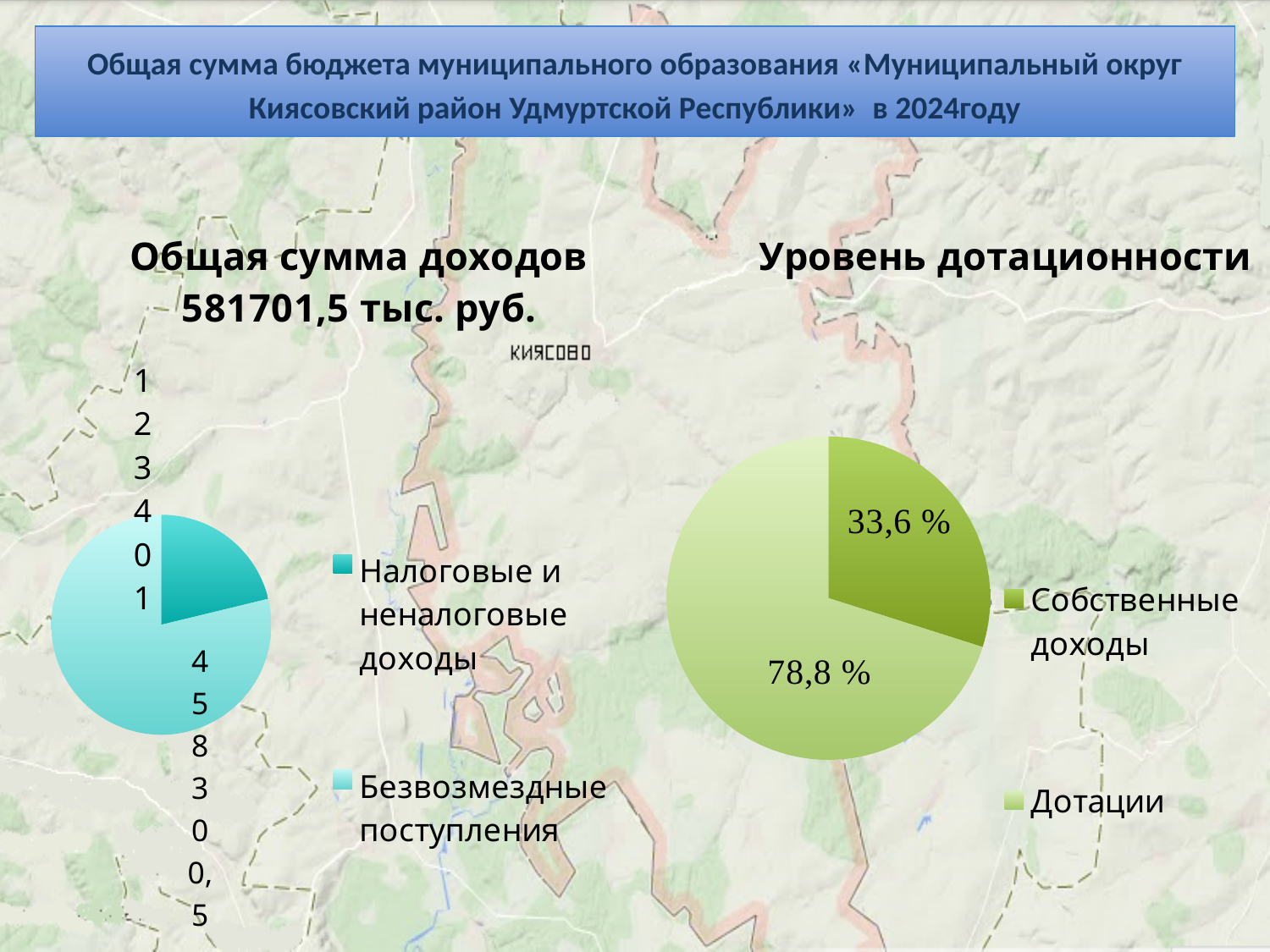
On the chart titled «Уровень дотационности», which category has the smaller slice? Собственные доходы On the chart titled «Уровень дотационности», what percentage is shown for «Дотации»? 78,8 % On the chart titled «Общая сумма доходов», what is the value for «Налоговые и неналоговые доходы»? 123401 On the chart titled «Общая сумма доходов», which category has the larger value? Безвозмездные поступления On the chart titled «Уровень дотационности», is the slice for «Дотации» larger or smaller than the slice for «Собственные доходы»? Larger On the chart titled «Общая сумма доходов», what is the value for «Безвозмездные поступления»? 458300,5 On the chart titled «Уровень дотационности», what percentage is shown for «Собственные доходы»? 33,6 % How many pie charts are shown on the slide? 2 What kind of chart is the one titled «Общая сумма доходов»? Pie chart On the chart titled «Общая сумма доходов», what is the difference between «Безвозмездные поступления» and «Налоговые и неналоговые доходы»? 335299,5 On the chart titled «Общая сумма доходов», what is the total of the two categories, as stated in the chart title? 581701,5 тыс. руб. How many categories does the legend of the chart titled «Общая сумма доходов» list? 2